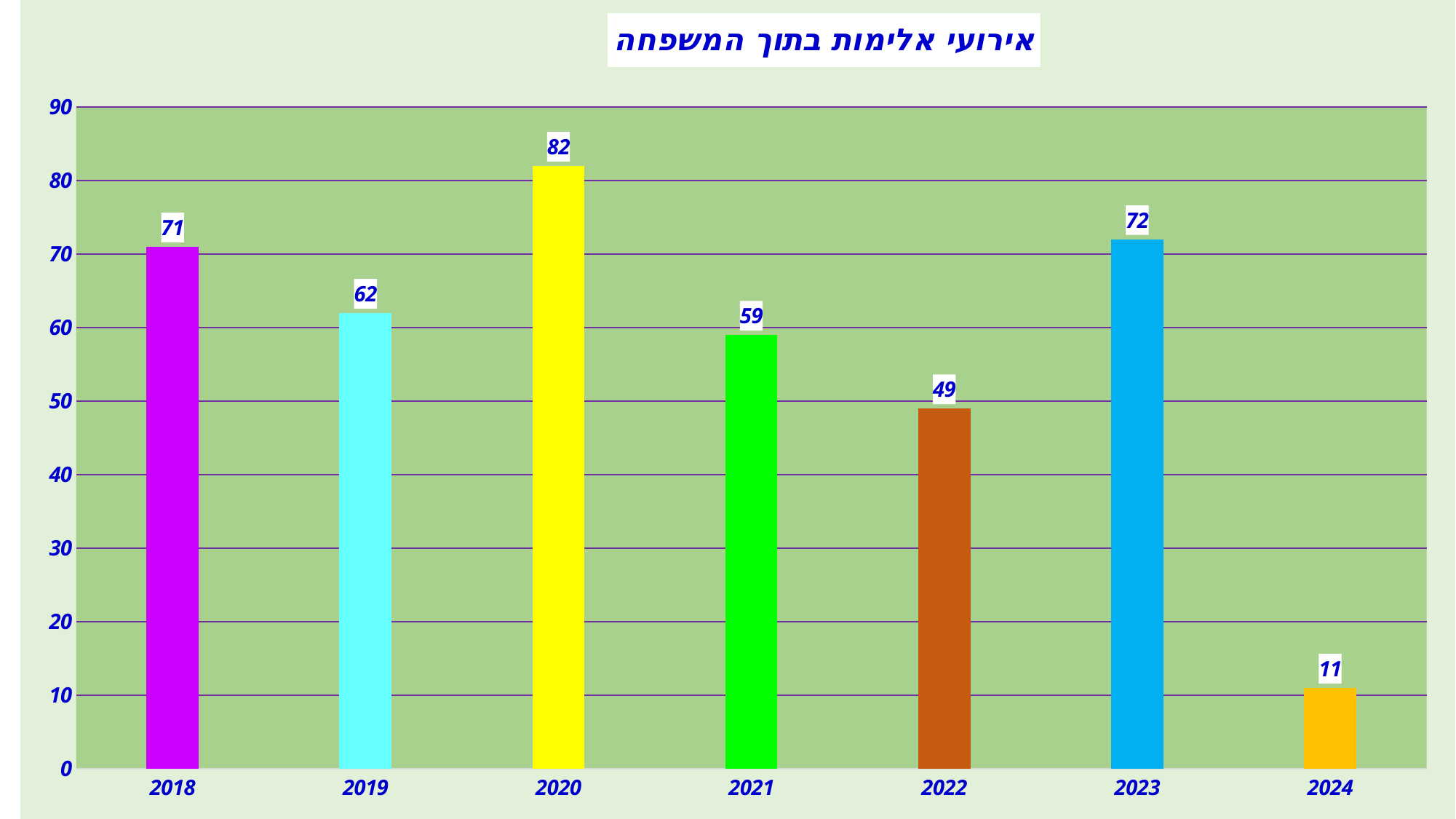
Which is larger, the value for 2019 or the value for 2022? 2019 What is the value for 2024? 11 What is the difference between the values for 2020 and 2021? 23 How many years are shown on the x axis? 7 Which year has the highest value? 2020 What is the value for 2022? 49 What is the value for 2020? 82 Is the value for 2021 greater or less than 50? greater What kind of chart is shown on the slide? bar chart Which year has the lowest value? 2024 What is the title of the chart? אירועי אלימות בתוך המשפחה What is the difference between the values for 2023 and 2024? 61